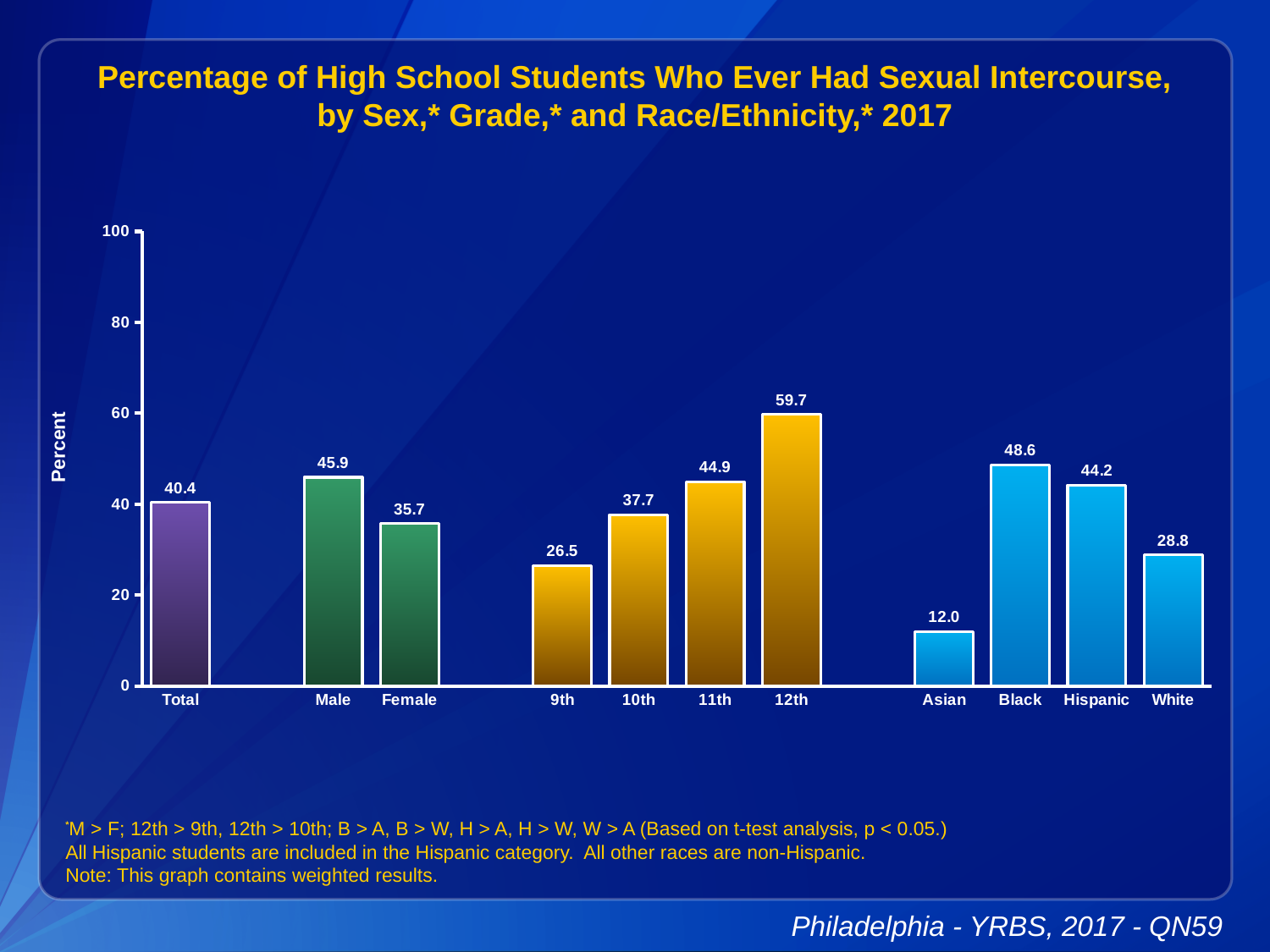
Which category has the lowest value? Asian What is the value for Total? 40.4 What is the value for Asian? 12.0 How many categories are shown on the x axis? 11 Is the value for White greater or less than 40? less Which category has the highest value? 12th Do the values rise or fall from 9th to 12th grade? rise What is the difference between the values for Male and Female? 10.2 What kind of chart is this? bar chart Which is larger, the value for Black or the value for Hispanic? Black What is the value for Female? 35.7 What is the difference between the values for 12th and 9th? 33.2